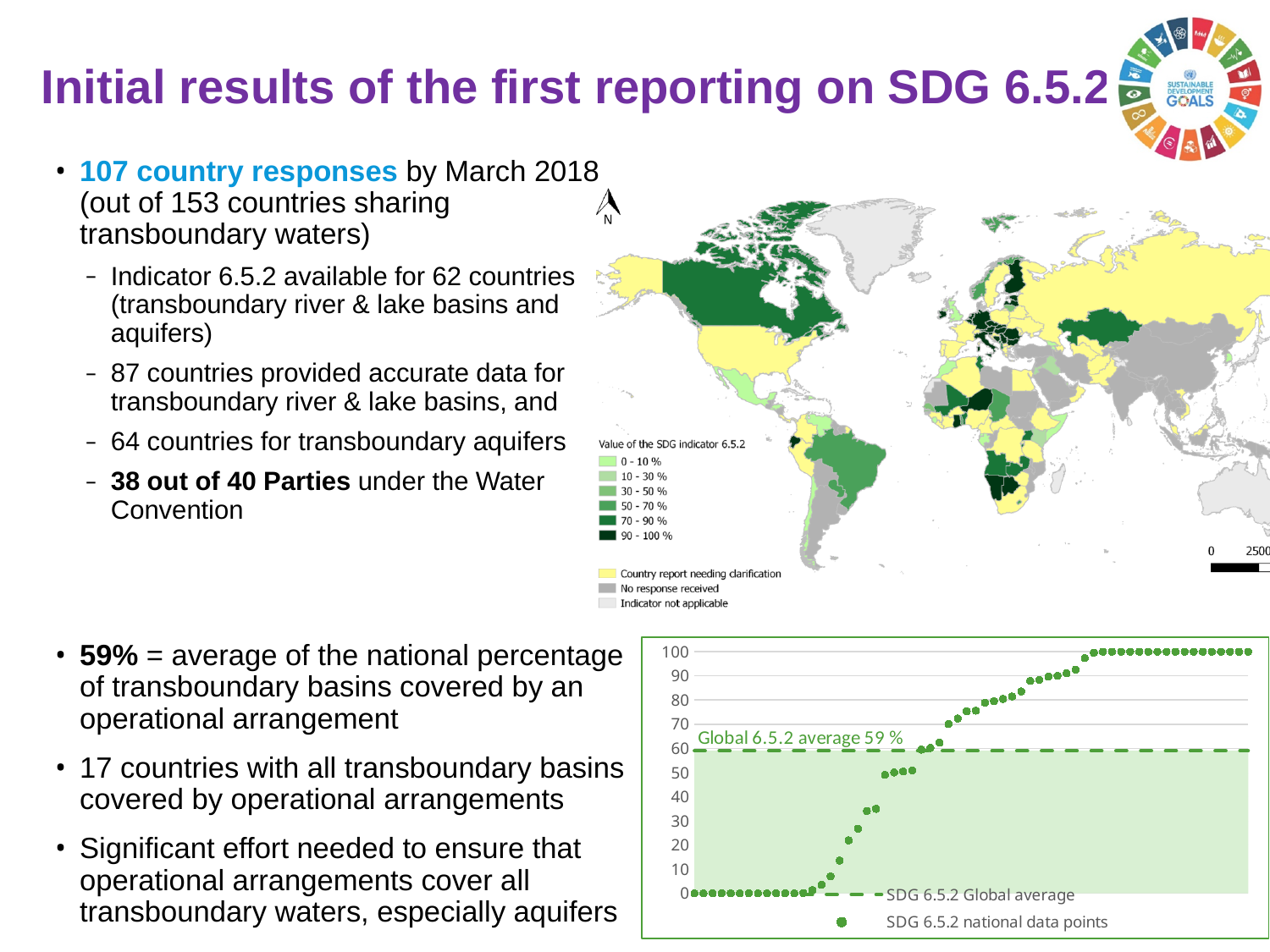
In the bottom-right chart, how many series does the legend list? 2 In the bottom-right chart, what is the highest value shown on the y axis? 100 In the bottom-right chart, what are the two legend entries? SDG 6.5.2 Global average; SDG 6.5.2 national data points What kind of chart is shown at the bottom right of the slide? A combination area and line chart (dot markers for national data points, a dashed line for the global average, and a shaded area beneath it) In the bottom-right chart, which is larger: the global average or the lowest national data points? The global average In the bottom-right chart, do the national data points rise or fall from left to right along the x axis? Rise In the bottom-right chart, what value is given for the global 6.5.2 average? 59 % In the map legend, which colour marks 'Country report needing clarification'? Yellow In the bottom-right chart, are the highest national data points greater or less than 90? greater In the bottom-right chart, are the lowest national data points greater or less than 10? less In the map legend, how many value classes are listed for the SDG indicator 6.5.2? 6 In the bottom-right chart, is the global average line greater or less than 50? greater